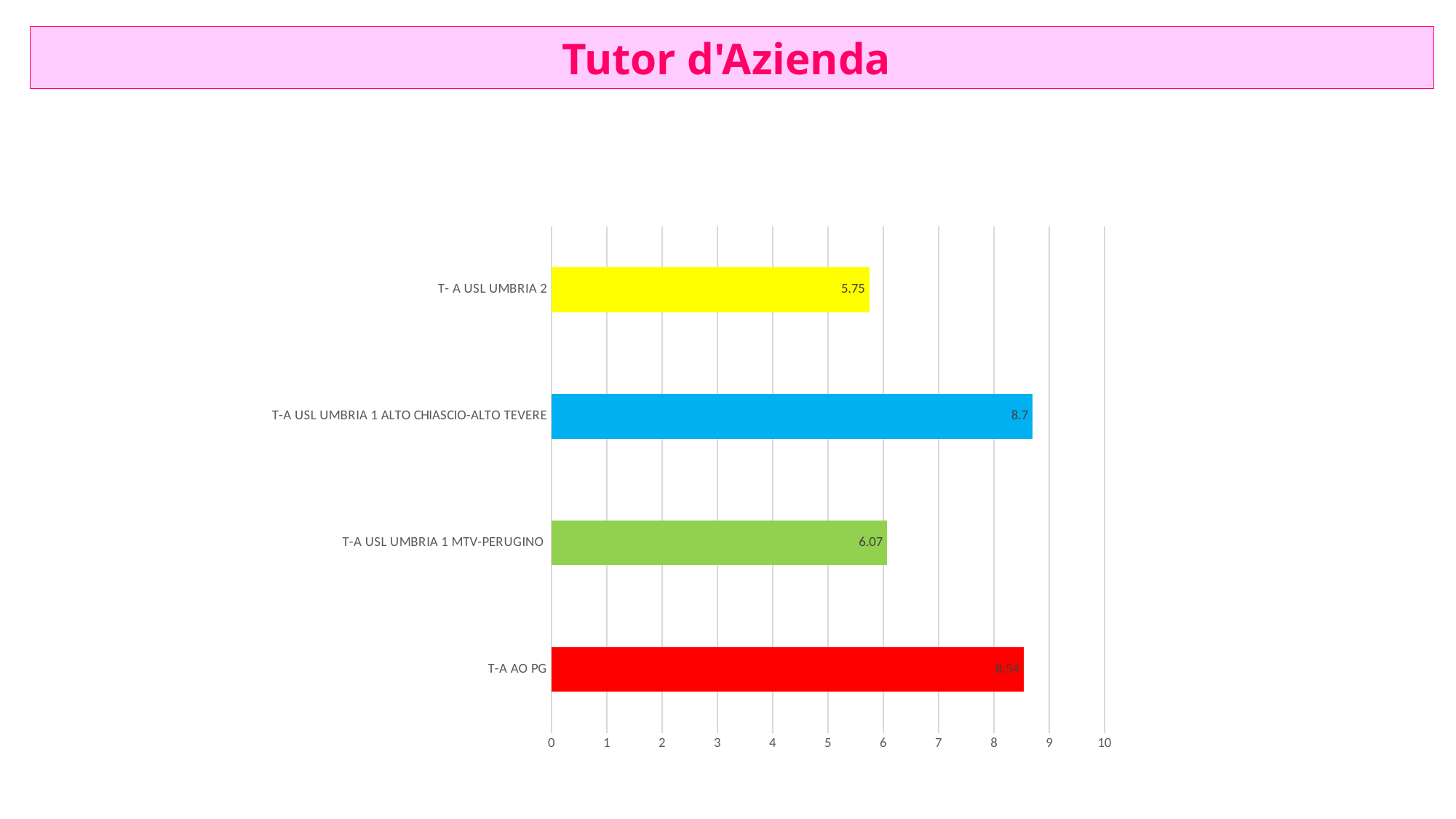
What is the value for T- A USL UMBRIA 2? 5.75 What is the value for T-A USL UMBRIA 1 ALTO CHIASCIO-ALTO TEVERE? 8.7 What kind of chart is shown on the slide? Bar chart What is the value for T-A USL UMBRIA 1 MTV-PERUGINO? 6.07 Which is larger, the value for T-A USL UMBRIA 1 MTV-PERUGINO or the value for T- A USL UMBRIA 2? T-A USL UMBRIA 1 MTV-PERUGINO What is the difference between the values for T-A USL UMBRIA 1 ALTO CHIASCIO-ALTO TEVERE and T- A USL UMBRIA 2? 2.95 Which category has the highest value? T-A USL UMBRIA 1 ALTO CHIASCIO-ALTO TEVERE What is the difference between the values for T-A AO PG and T-A USL UMBRIA 1 MTV-PERUGINO? 2.47 What is the title of the slide? Tutor d'Azienda How many categories are shown in the chart? 4 What is the value for T-A AO PG? 8.54 Which category has the lowest value? T- A USL UMBRIA 2